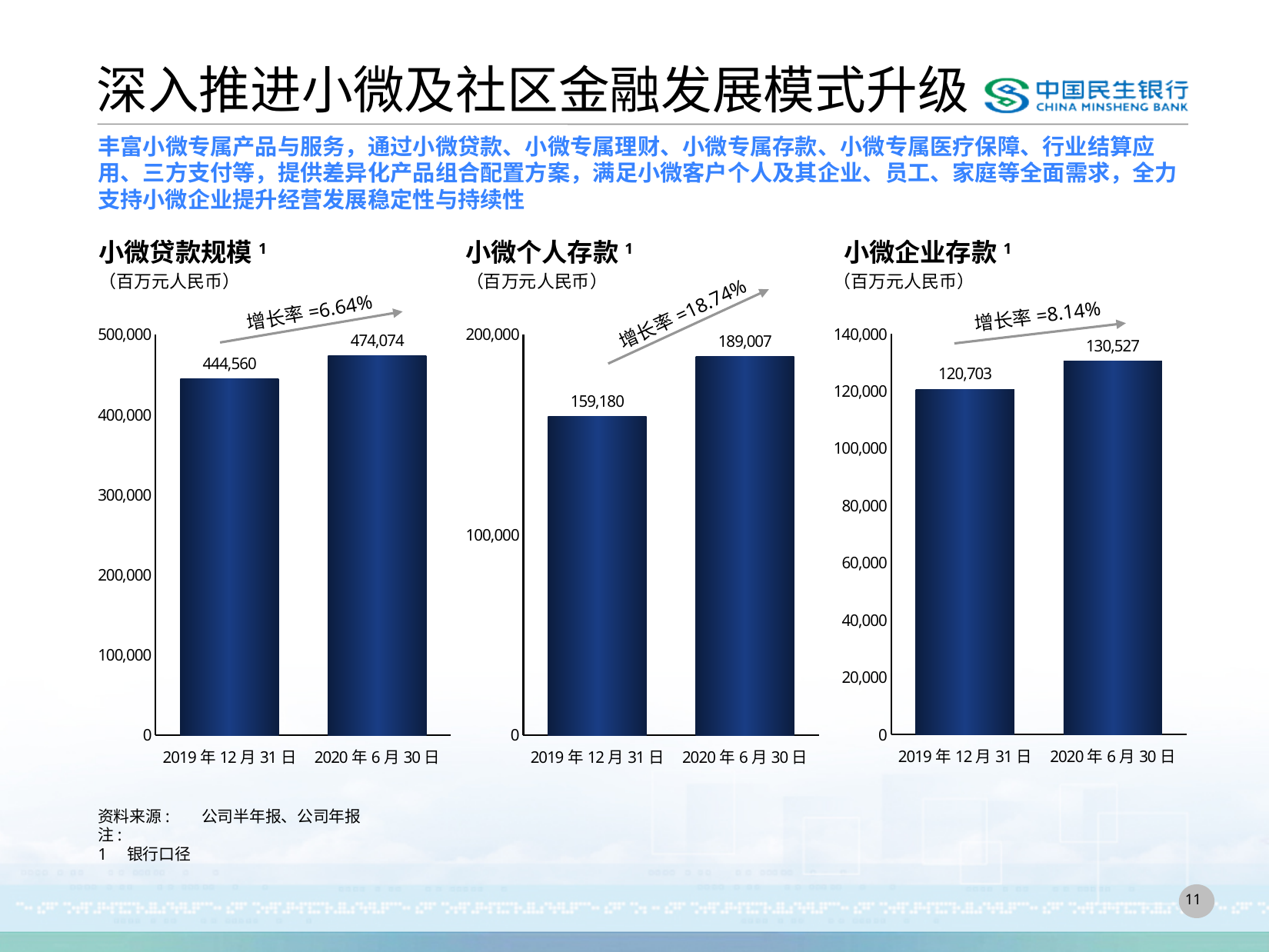
In the 小微贷款规模 chart, what is the value for 2020 年 6 月 30 日? 474,074 What growth rate (增长率) is shown on the 小微个人存款 chart? 18.74% What kind of chart is the 小微个人存款 chart? bar chart In the 小微企业存款 chart, which date has the lower value? 2019 年 12 月 31 日 In the 小微贷款规模 chart, what is the value for 2019 年 12 月 31 日? 444,560 In the 小微企业存款 chart, what is the difference between the 2020 年 6 月 30 日 value and the 2019 年 12 月 31 日 value? 9,824 In the 小微贷款规模 chart, do the values rise or fall from 2019 年 12 月 31 日 to 2020 年 6 月 30 日? rise In the 小微个人存款 chart, what is the value for 2019 年 12 月 31 日? 159,180 In the 小微个人存款 chart, what is the value for 2020 年 6 月 30 日? 189,007 In the 小微企业存款 chart, what is the value for 2020 年 6 月 30 日? 130,527 In the 小微个人存款 chart, which date has the higher value? 2020 年 6 月 30 日 In the 小微贷款规模 chart, what is the difference between the 2020 年 6 月 30 日 value and the 2019 年 12 月 31 日 value? 29,514